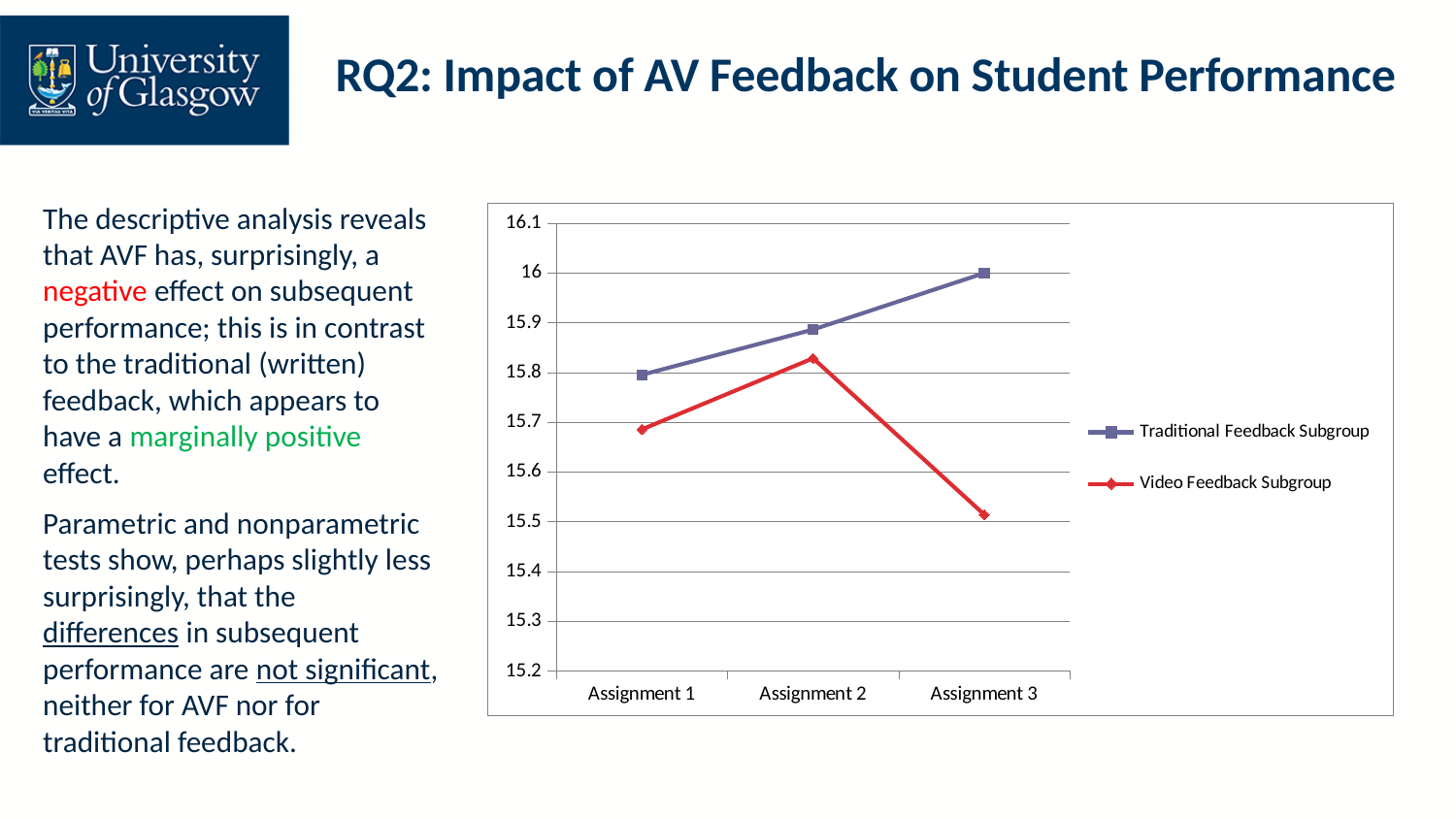
At Assignment 1, which subgroup has the higher value? Traditional Feedback Subgroup At which assignment does the Video Feedback Subgroup reach its highest value? Assignment 2 What colour is the line for the Video Feedback Subgroup? red What kind of chart is shown on the slide? line chart Is the value for the Video Feedback Subgroup at Assignment 3 greater or less than 15.6? less At which assignment does the Video Feedback Subgroup have its lowest value? Assignment 3 Is the value for the Traditional Feedback Subgroup at Assignment 1 greater or less than 15.7? greater How many series does the chart's legend list? 2 Is the value for the Video Feedback Subgroup at Assignment 2 greater or less than 15.9? less How many assignments are plotted along the x axis? 3 At Assignment 3, which subgroup has the higher value? Traditional Feedback Subgroup Does the Traditional Feedback Subgroup line rise or fall from Assignment 1 to Assignment 3? rise